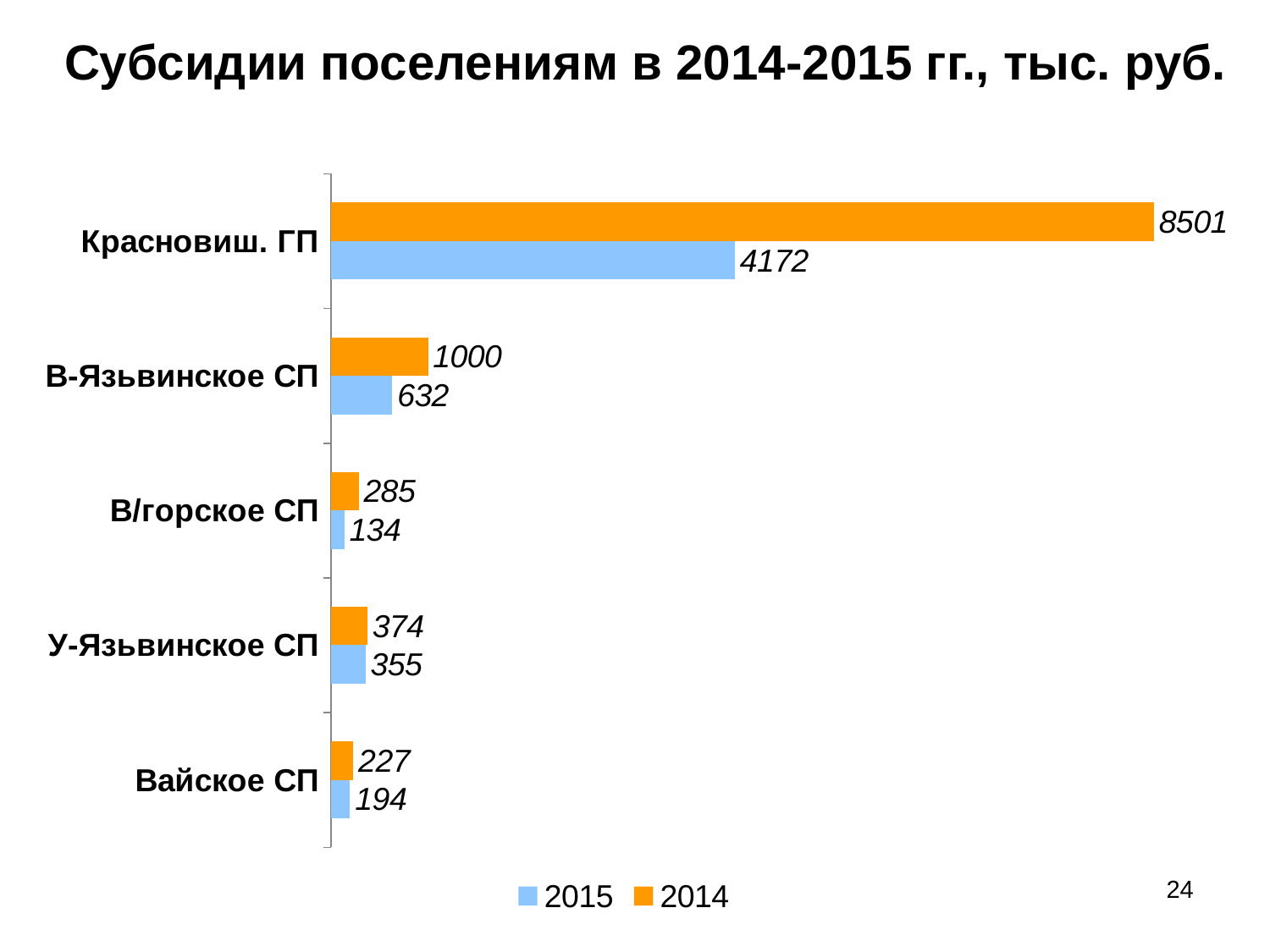
What is the difference between the 2014 and 2015 values for У-Язьвинское СП? 19 Which category has the lowest 2015 value? В/горское СП Which colour represents the 2014 series? Orange What is the 2015 value for В-Язьвинское СП? 632 How many series does the legend list? 2 How many categories are shown on the chart? 5 Which category has the highest 2014 value? Красновиш. ГП What is the 2015 value for Вайское СП? 194 What is the 2014 value for Красновиш. ГП? 8501 What kind of chart is shown on the slide? Bar chart Which is larger: the 2014 value for В/горское СП or the 2014 value for У-Язьвинское СП? У-Язьвинское СП What is the difference between the 2014 and 2015 values for Красновиш. ГП? 4329